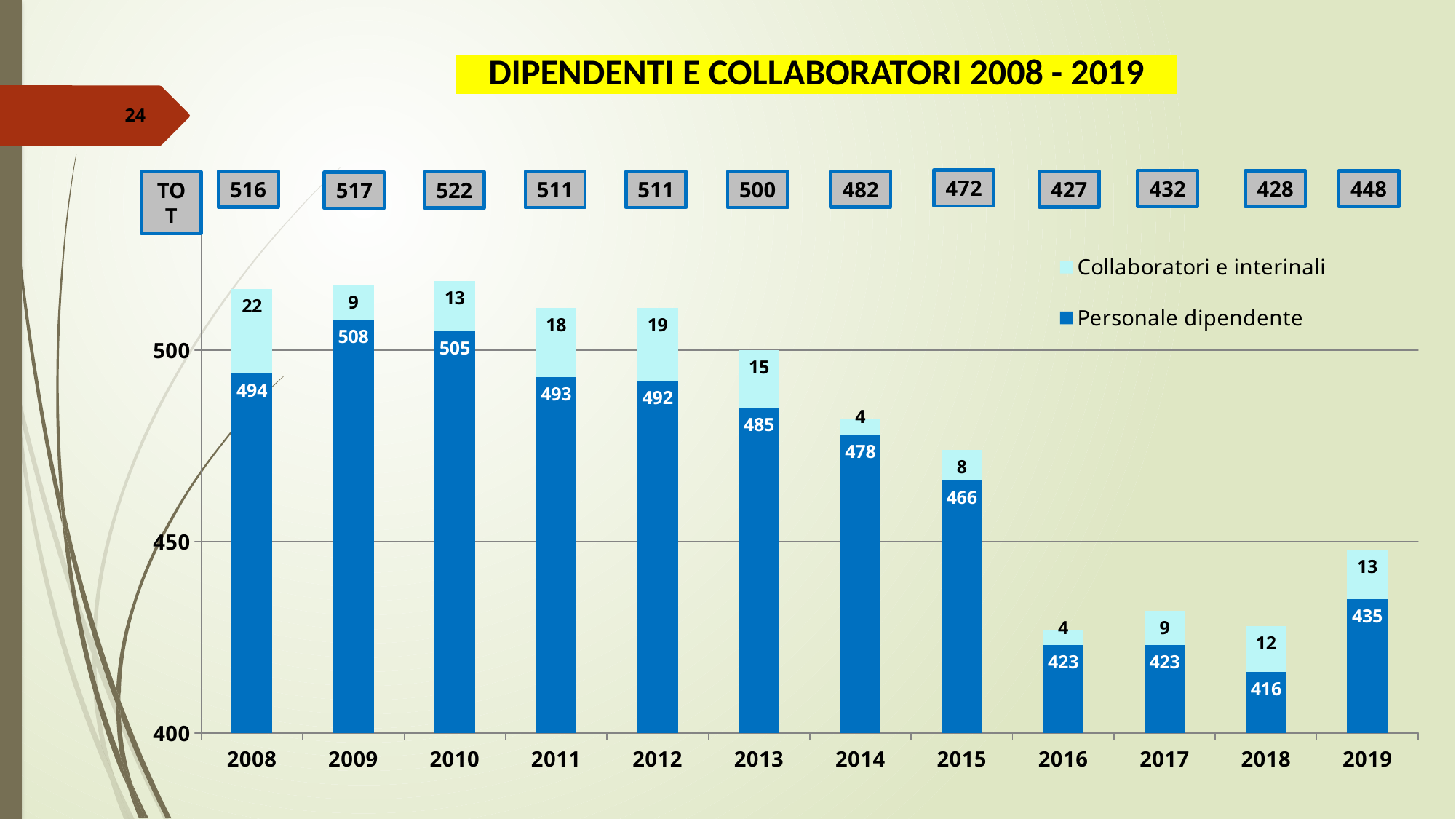
Which is larger, the Collaboratori e interinali value for 2012 or for 2013? 2012 How many series does the legend list? 2 What is the value of Collaboratori e interinali for 2008? 22 What is the title of the chart? DIPENDENTI E COLLABORATORI 2008 - 2019 What is the total of the stacked bar for 2016? 427 How many years are shown on the x axis? 12 What kind of chart is shown on the slide? Stacked bar chart What is the value of Personale dipendente for 2010? 505 Which year has the lowest value for Personale dipendente? 2018 Is the Personale dipendente value for 2015 greater or less than 450? greater What is the difference between the Personale dipendente values for 2008 and 2019? 59 Which year has the highest value for Personale dipendente? 2009